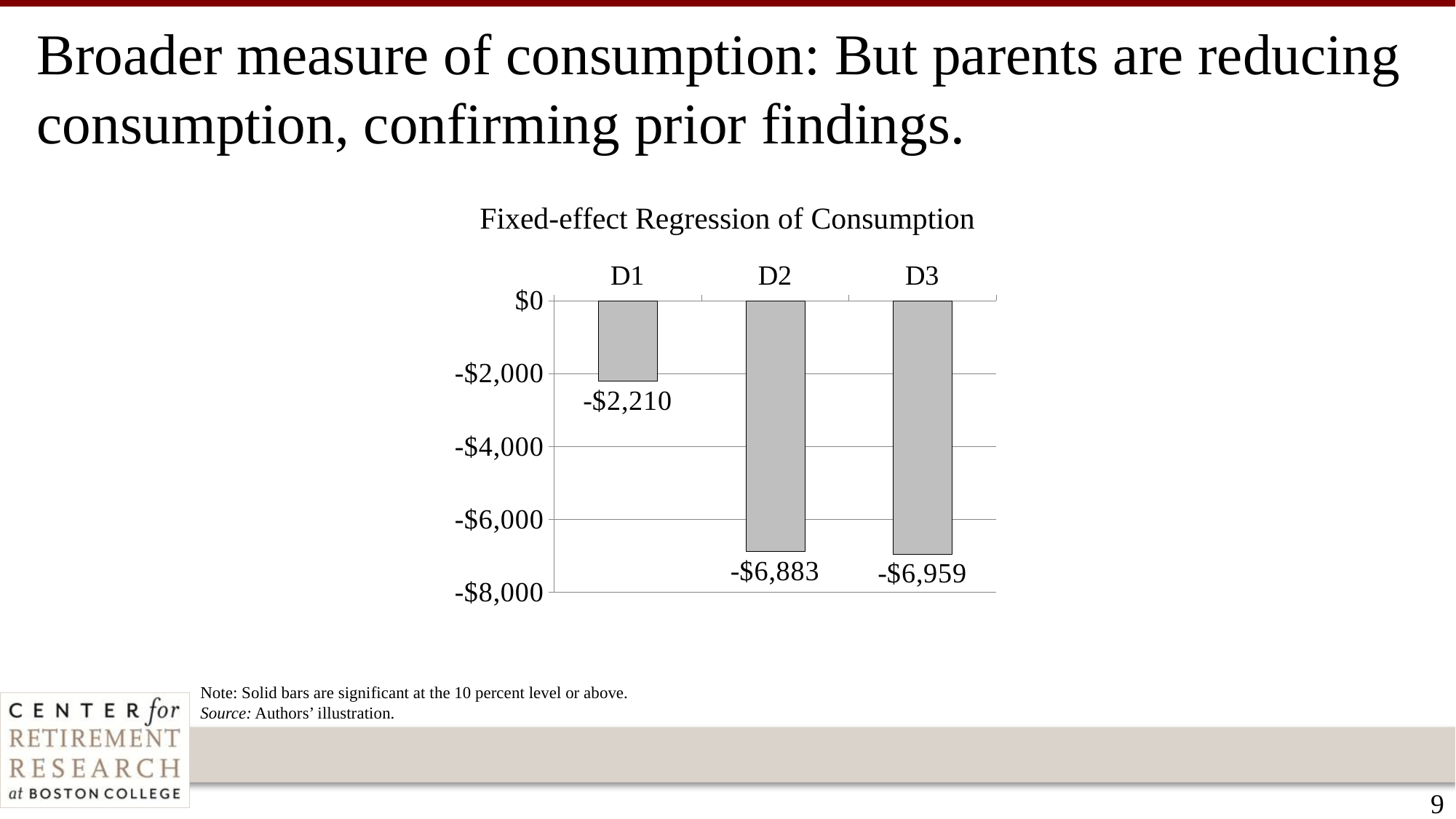
What is the value for D1 in the Fixed-effect Regression of Consumption chart? -$2,210 What is the difference between the values for D2 and D3? $76 Is the value for D1 greater or less than -$2,000? less What is the difference between the values for D1 and D2? $4,673 What is the value for D3 in the chart? -$6,959 Which category has the highest (least negative) value in the chart? D1 What is the value for D2 in the chart? -$6,883 What kind of chart is shown on the slide? Bar chart Which category has the lowest (most negative) value in the chart? D3 Which has the larger (less negative) value, D1 or D2? D1 What is the title of the chart? Fixed-effect Regression of Consumption How many categories are shown in the chart? 3